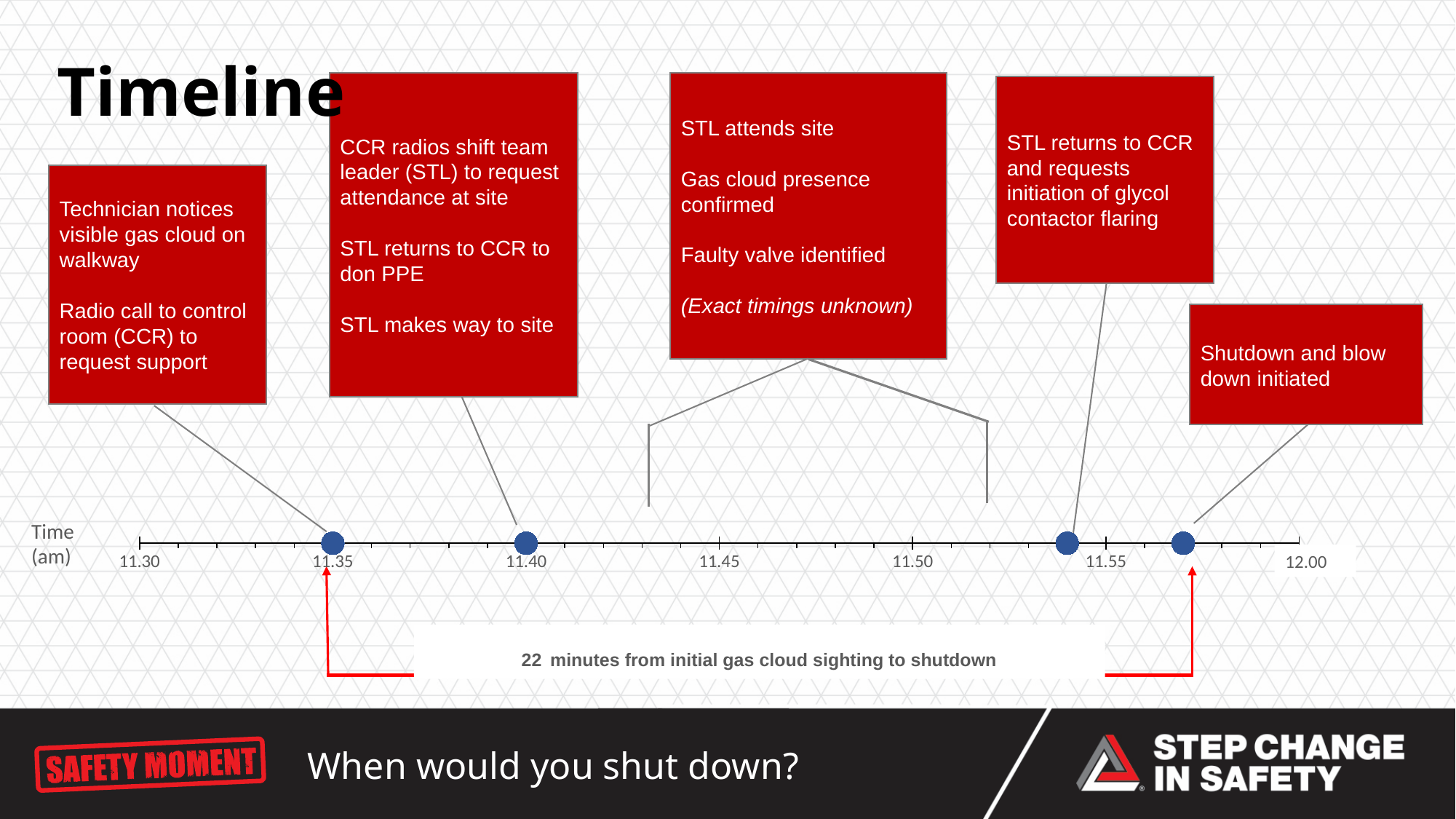
Is the time at which the STL returns to CCR and requests initiation of glycol contactor flaring before or after 11.50? after How many minutes elapsed from the initial gas cloud sighting to shutdown? 22 minutes Is the time of 'Shutdown and blow down initiated' before or after 11.55? after At what time does the technician notice the visible gas cloud on the walkway? 11.35 Which event is the latest on the timeline? Shutdown and blow down initiated What are the first and last time labels shown on the timeline axis? 11.30 and 12.00 How many minutes are there between the technician noticing the gas cloud and the CCR radioing the STL? 5 minutes Which event is the earliest on the timeline? Technician notices visible gas cloud on walkway How many event markers (dots) are plotted on the timeline axis? 4 What is the label of the timeline axis? Time (am) What kind of chart is shown on the slide? Timeline chart At what time does the CCR radio the shift team leader to request attendance at site? 11.40